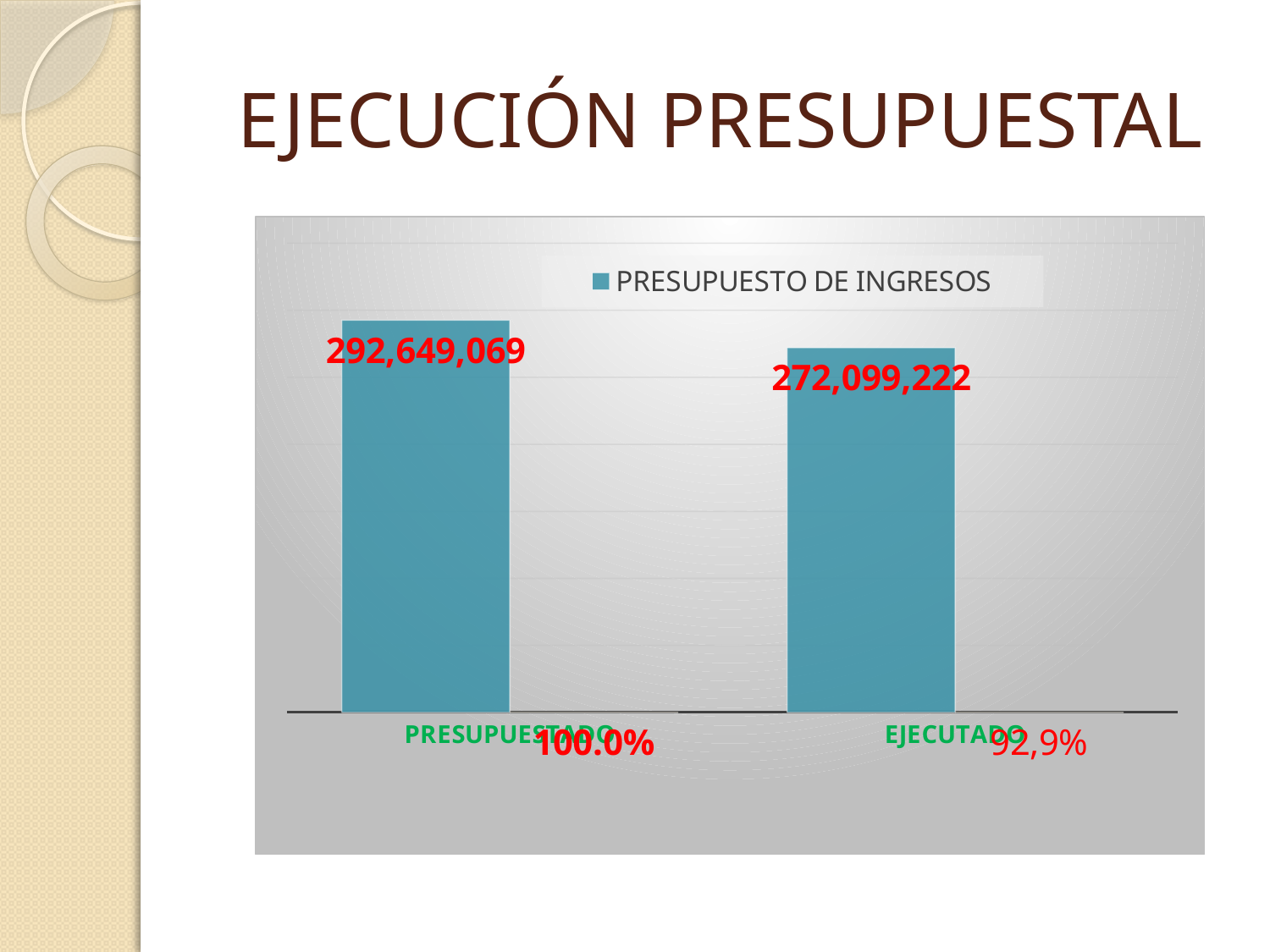
How many bars are plotted in the chart? 2 What series name is shown in the chart legend? PRESUPUESTO DE INGRESOS What is the difference between the PRESUPUESTADO and EJECUTADO values? 20,549,847 Do the values rise or fall from PRESUPUESTADO to EJECUTADO? Fall How many series does the legend list? 1 Which category has the lowest value? EJECUTADO What is the value of the PRESUPUESTADO bar? 292,649,069 What kind of chart is shown on the slide? Bar chart What is the value of the EJECUTADO bar? 272,099,222 Which category has the highest value? PRESUPUESTADO Which is larger, the PRESUPUESTADO value or the EJECUTADO value? PRESUPUESTADO What percentage is shown beneath the EJECUTADO bar? 92,9%